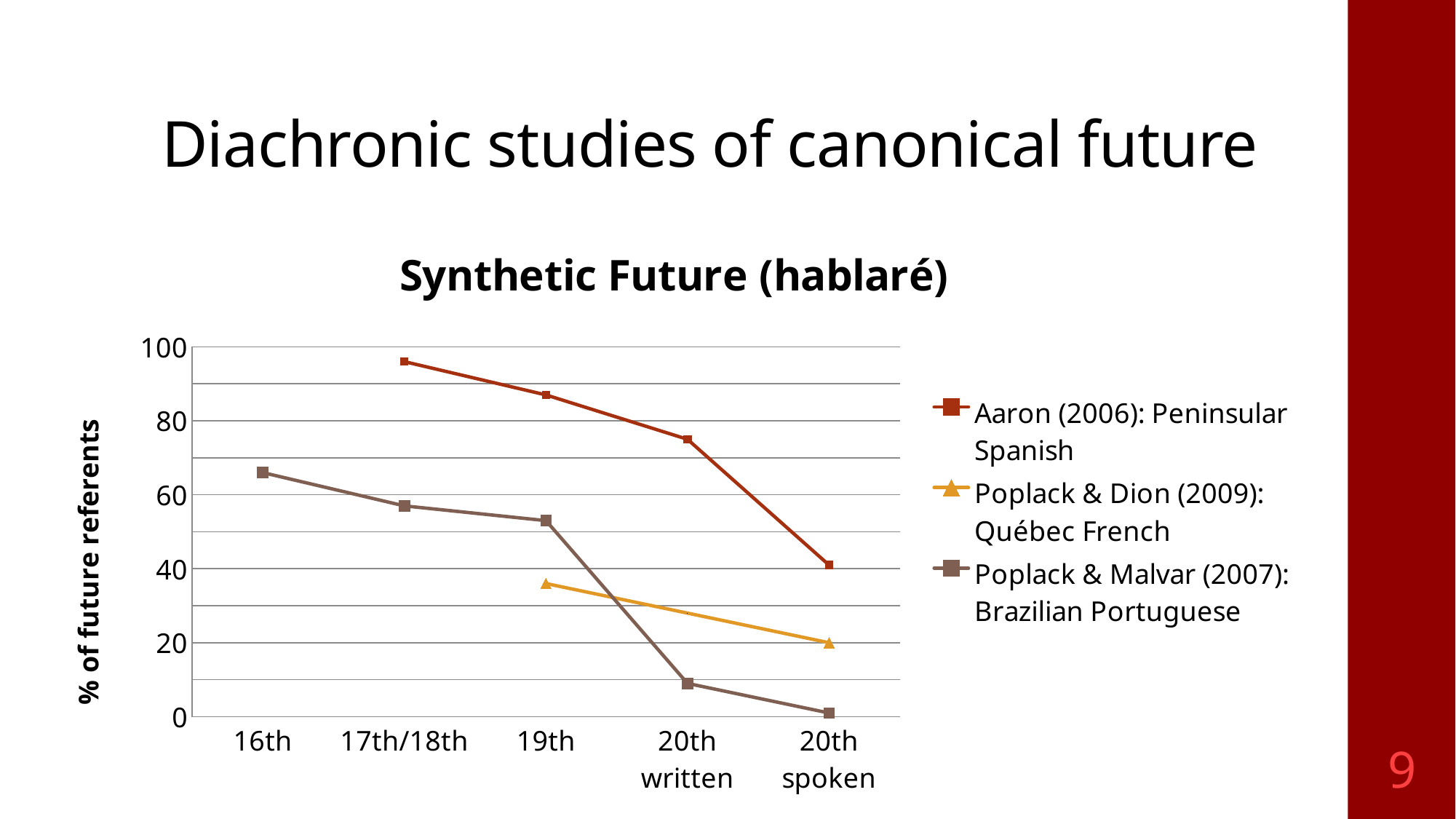
How many categories are shown on the x axis? 5 How many series does the legend list? 3 What kind of chart is shown on the slide? line chart At 19th, which is larger: Aaron (2006): Peninsular Spanish or Poplack & Malvar (2007): Brazilian Portuguese? Aaron (2006): Peninsular Spanish Is the value for Poplack & Malvar (2007): Brazilian Portuguese at 20th written greater or less than 20? less Do the values for Poplack & Malvar (2007): Brazilian Portuguese rise or fall along the x axis? fall Do the values for Aaron (2006): Peninsular Spanish rise or fall along the x axis? fall Which series has the highest value at 20th spoken? Aaron (2006): Peninsular Spanish At 20th spoken, which is larger: Poplack & Dion (2009): Québec French or Poplack & Malvar (2007): Brazilian Portuguese? Poplack & Dion (2009): Québec French What is the title of the y axis? % of future referents Is the value for Poplack & Dion (2009): Québec French at 19th greater or less than 40? less Is the value for Aaron (2006): Peninsular Spanish at 17th/18th greater or less than 90? greater